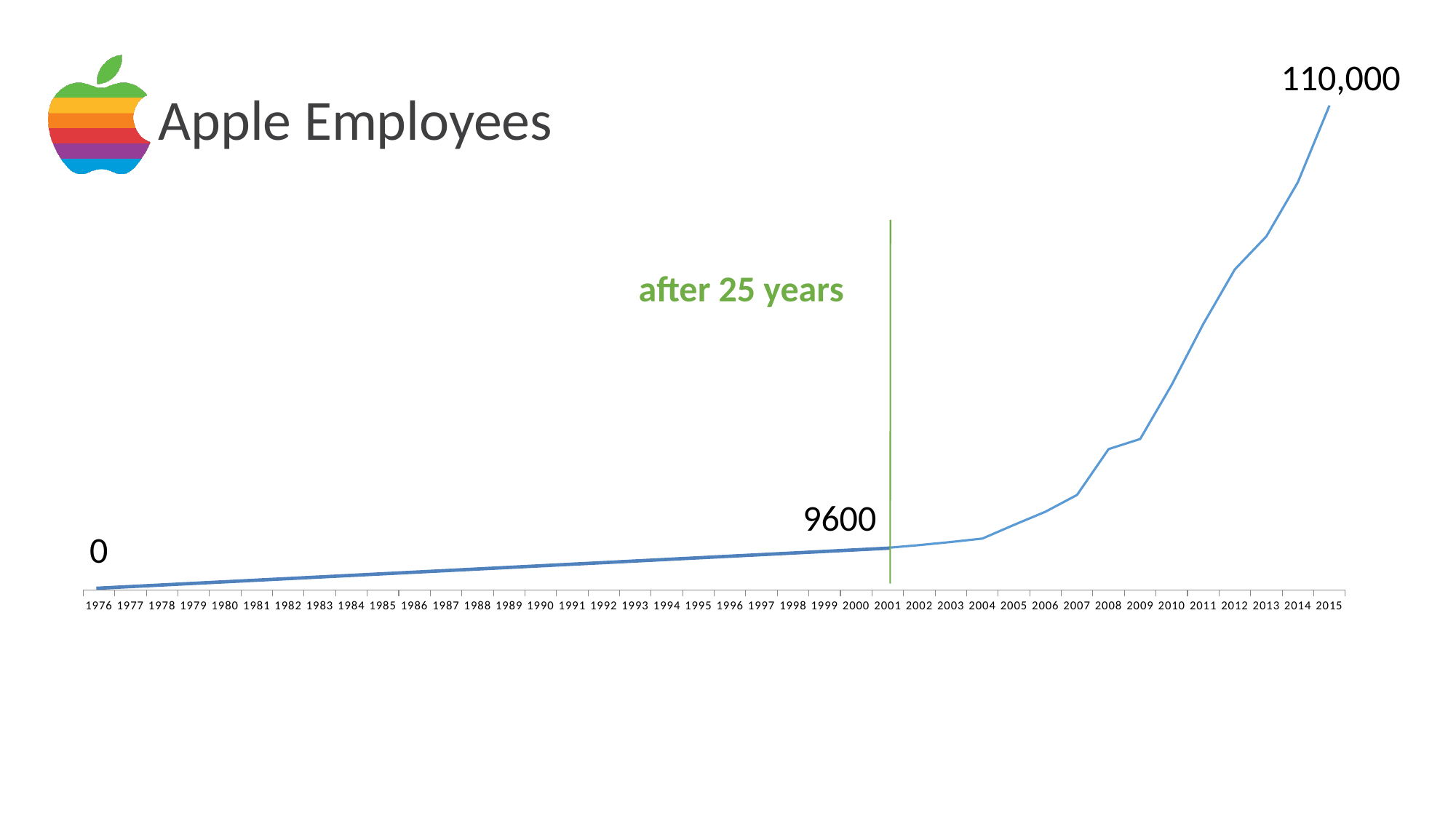
What is the difference between the number of employees in 2015 and in 2001? 100,400 What is the title of the chart? Apple Employees What is the difference between the number of employees in 2001 and in 1976? 9600 Which year has the highest number of employees? 2015 What is the number of Apple employees shown for 2001? 9600 What is the number of Apple employees shown for 2015? 110,000 What is the number of Apple employees shown for 1976? 0 Do the values rise or fall from 1976 to 2015? rise What kind of chart is shown on the slide? line chart Which year has more employees, 2001 or 2015? 2015 Which year has the lowest number of employees? 1976 How many years are shown on the x axis? 40